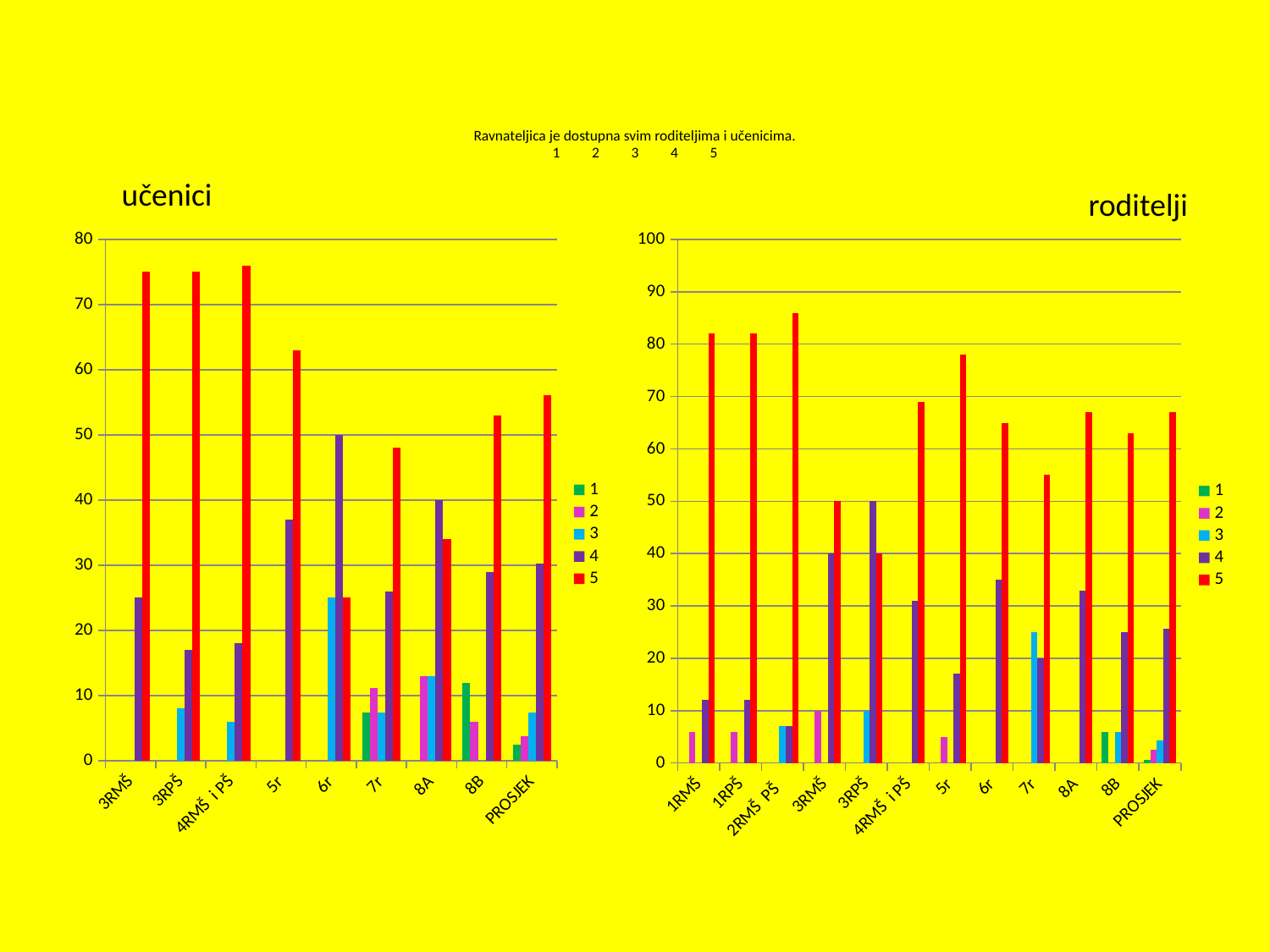
How many series does the legend of the 'roditelji' chart list? 5 How many categories are shown on the x axis of the 'roditelji' chart? 12 In the 'roditelji' chart, which category has the lowest value for series 5? 3RPŠ In the 'roditelji' chart, which is larger for series 4: 3RPŠ or 5r? 3RPŠ In the 'roditelji' chart, is the value of series 3 for 7r greater or less than 20? greater In the 'roditelji' chart, is the value of series 5 for 5r greater or less than 70? greater In the 'učenici' chart, which is larger for series 5: 3RMŠ or 6r? 3RMŠ What kind of chart is the 'učenici' chart on the left? bar chart In the 'roditelji' chart, which category has the highest value for series 5? 2RMŠ PŠ In the 'učenici' chart, is the value of series 5 for 5r greater or less than 60? greater In the 'učenici' chart, which category has the lowest value for series 5? 6r How many categories are shown on the x axis of the 'učenici' chart? 9